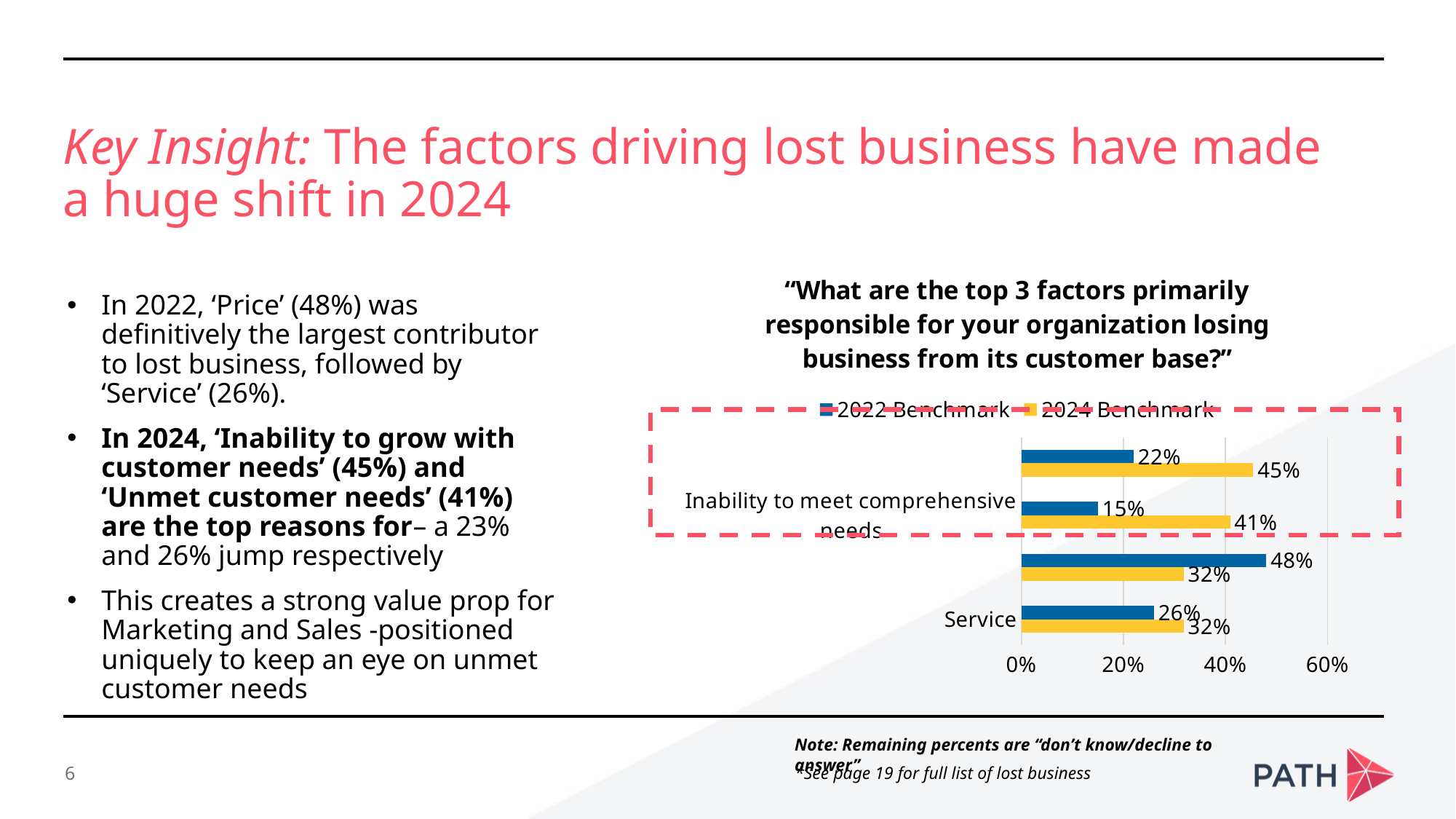
How many categories (pairs of bars) are plotted in the chart? 4 What is the highest value shown in the chart? 48% What is the 2022 Benchmark value for 'Inability to meet comprehensive needs'? 15% What colour are the 2024 Benchmark bars? Yellow What type of chart is shown on the slide? Bar chart For Service, which series has the larger value, 2022 Benchmark or 2024 Benchmark? 2024 Benchmark What is the 2024 Benchmark value for Service? 32% What is the difference between the 2024 Benchmark and 2022 Benchmark values for Service? 6 percentage points What is the 2024 Benchmark value for 'Inability to meet comprehensive needs'? 41% By how many percentage points did 'Inability to meet comprehensive needs' increase from the 2022 Benchmark to the 2024 Benchmark? 26 percentage points What is the 2022 Benchmark value for Service? 26% How many series does the chart legend list? 2